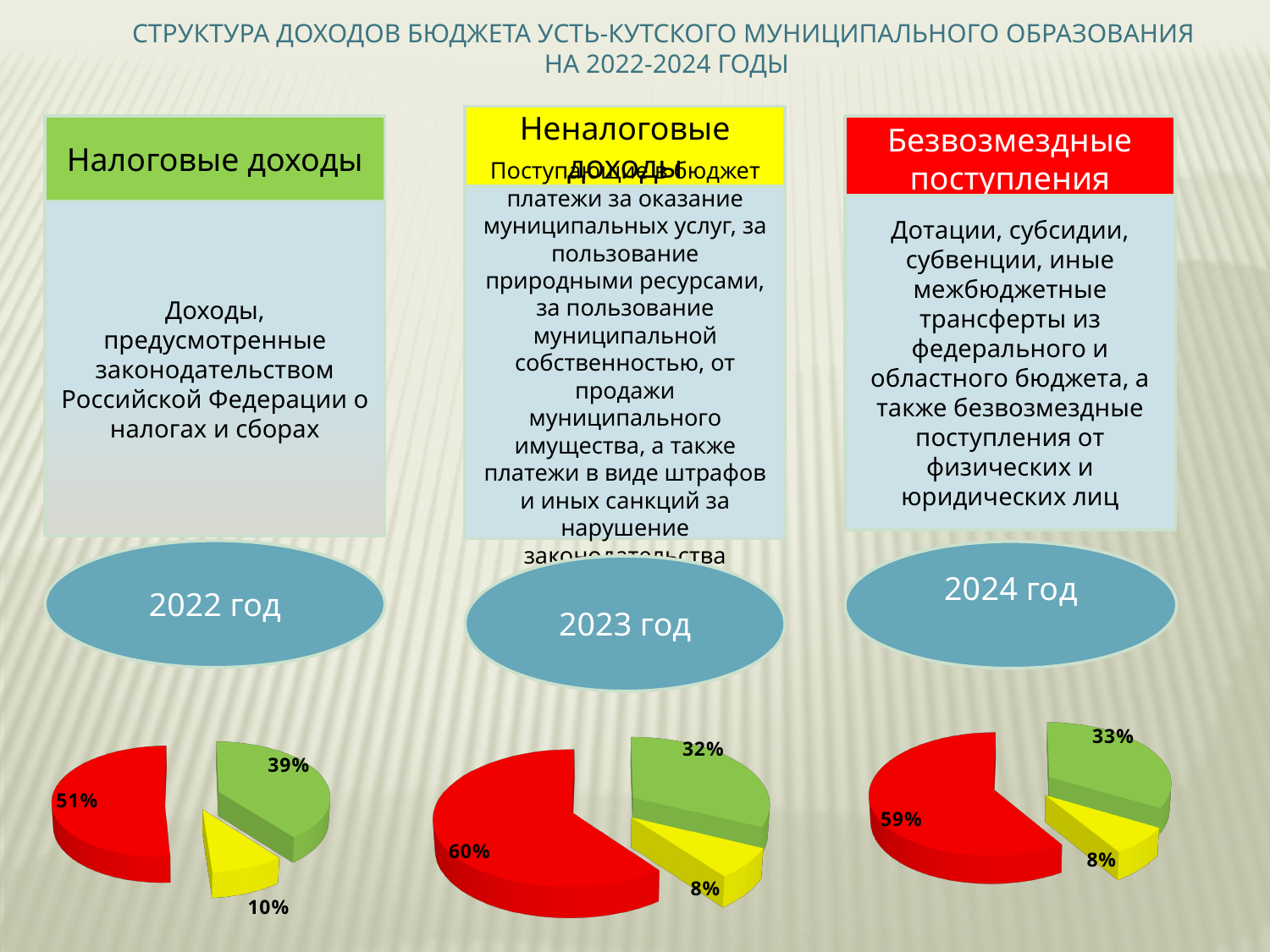
In the 2022 год pie chart, which slice is the smallest? the yellow slice (Неналоговые доходы), 10% Comparing the 2022 год and 2023 год pie charts, does the share of the green slice (Налоговые доходы) rise or fall? fall (39% to 32%) How many pie charts are shown on the slide? 3 In the 2023 год pie chart, what percentage is shown on the green slice (Налоговые доходы)? 32% In the 2024 год pie chart, what percentage is shown on the yellow slice (Неналоговые доходы)? 8% In the 2022 год pie chart, what is the difference between the red slice (51%) and the green slice (39%)? 12% In the 2022 год pie chart, what percentage is shown on the red slice (Безвозмездные поступления)? 51% In the 2023 год pie chart, what is the combined share of the green (32%) and yellow (8%) slices? 40% In the 2023 год pie chart, which slice is the largest? the red slice (Безвозмездные поступления), 60% What kind of chart is shown under the "2022 год" label? pie chart How many slices does the 2023 год pie chart have? 3 In the 2024 год pie chart, which is larger: the green slice or the yellow slice? the green slice (33%)